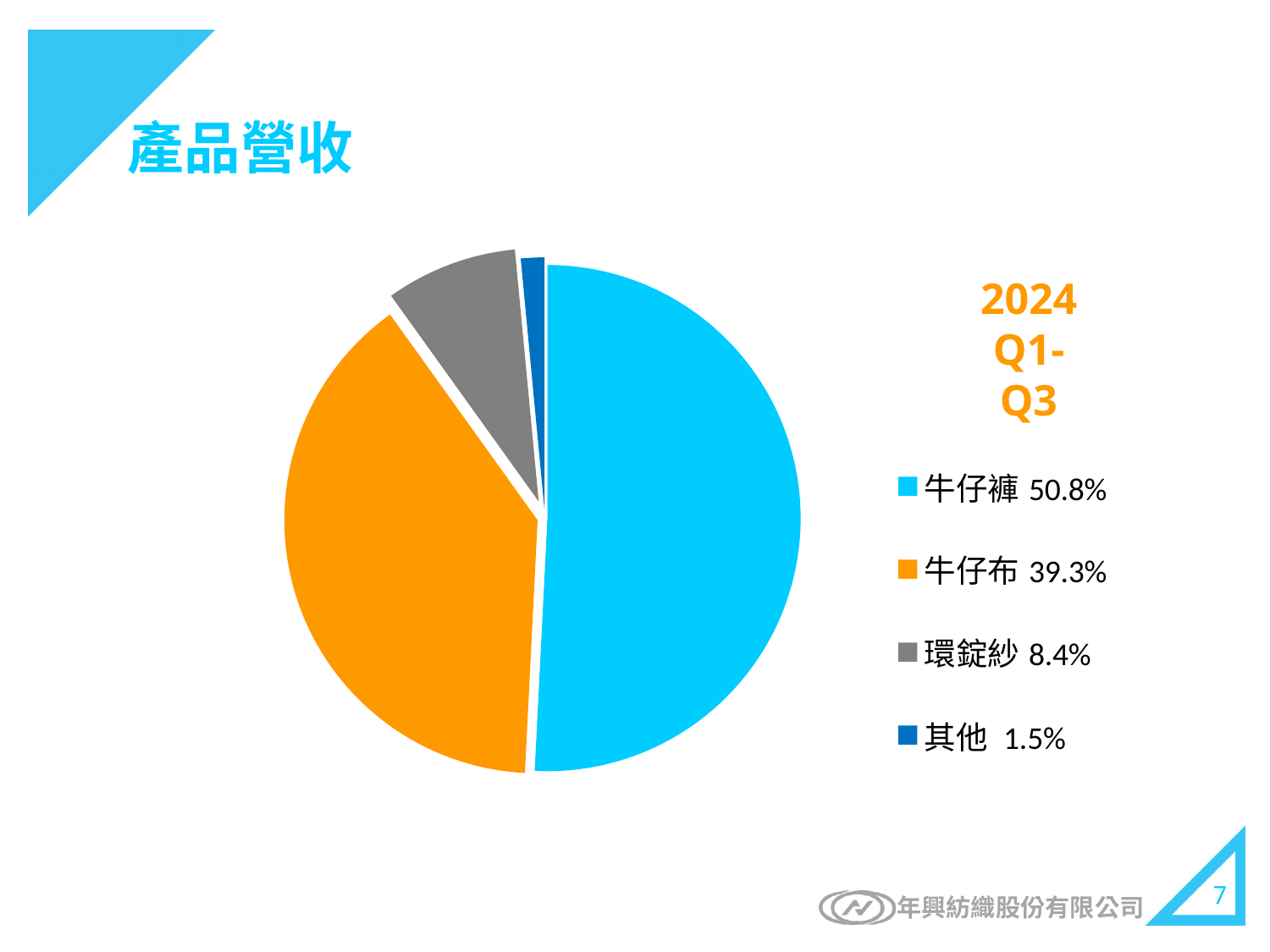
What share of product revenue does 環錠紗 account for? 8.4% How many product categories are shown in the pie chart? 4 What period does the chart cover, according to the label next to the legend? 2024 Q1-Q3 What is the difference in percentage points between the shares of 牛仔褲 and 牛仔布? 11.5 What is the difference in percentage points between the shares of 環錠紗 and 其他? 6.9 What share of product revenue does 其他 account for? 1.5% What share of product revenue does 牛仔褲 account for? 50.8% Which product category has the smallest share of revenue? 其他 Which product category has the largest share of revenue? 牛仔褲 Which has a larger share of revenue, 牛仔布 or 環錠紗? 牛仔布 What kind of chart is shown on the slide? pie chart